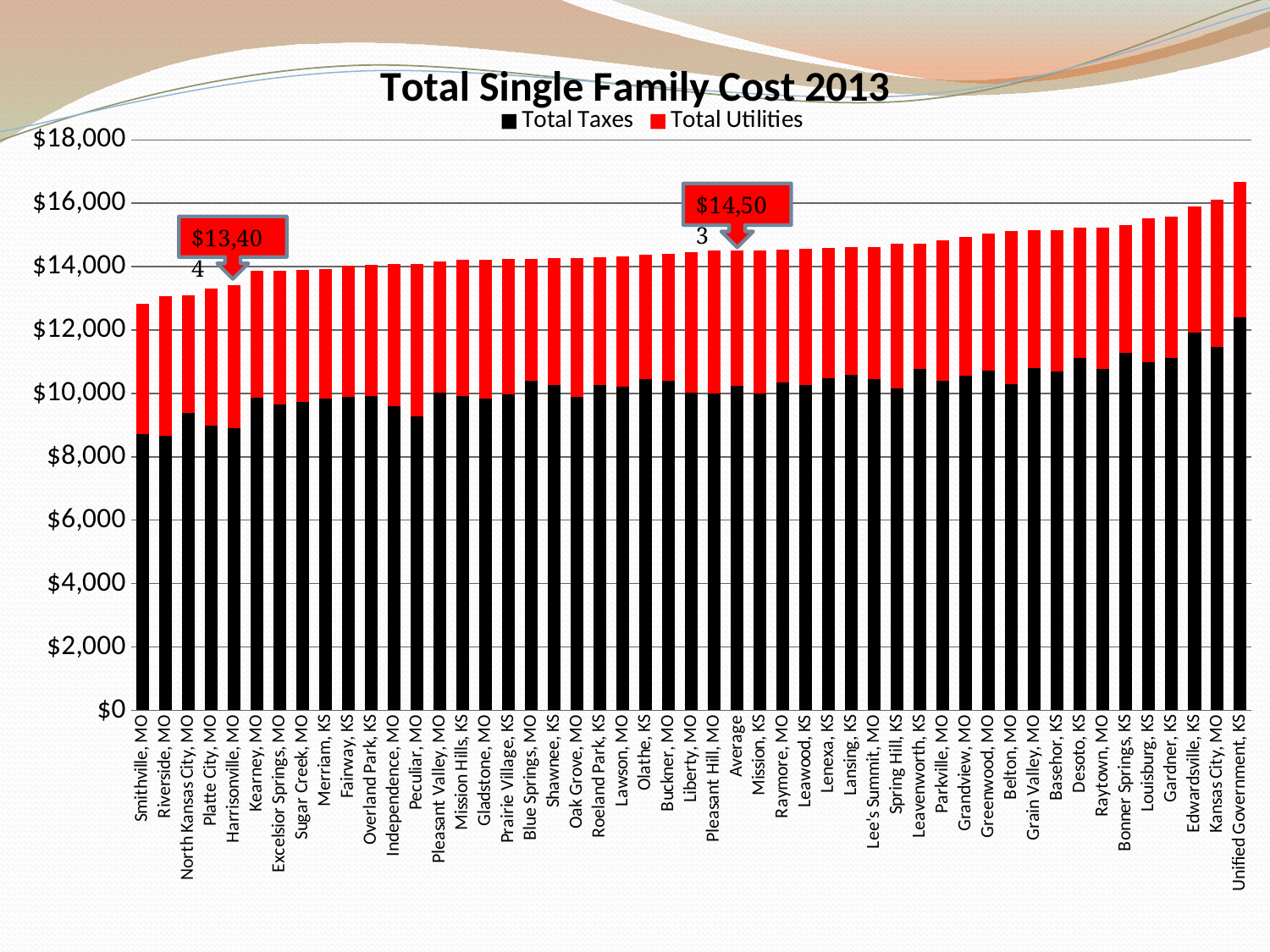
Is the total value for Unified Government, KS greater or less than $16,000? greater Do the total bar heights generally rise or fall from left to right along the x axis? Rise What total value is shown in the callout pointing at the Average bar? $14,503 Is the Total Taxes value for Edwardsville, KS greater or less than $10,000? greater What colour represents Total Utilities in the chart? Red What total value is shown in the callout pointing at Harrisonville, MO? $13,404 Is the total value for Smithville, MO greater or less than $14,000? less How many series does the legend list? 2 What kind of chart is shown on the slide? Stacked bar chart Which has the larger Total Taxes value, Smithville, MO or Edwardsville, KS? Edwardsville, KS Which category has the highest total single family cost? Unified Government, KS Which category has the lowest total single family cost? Smithville, MO